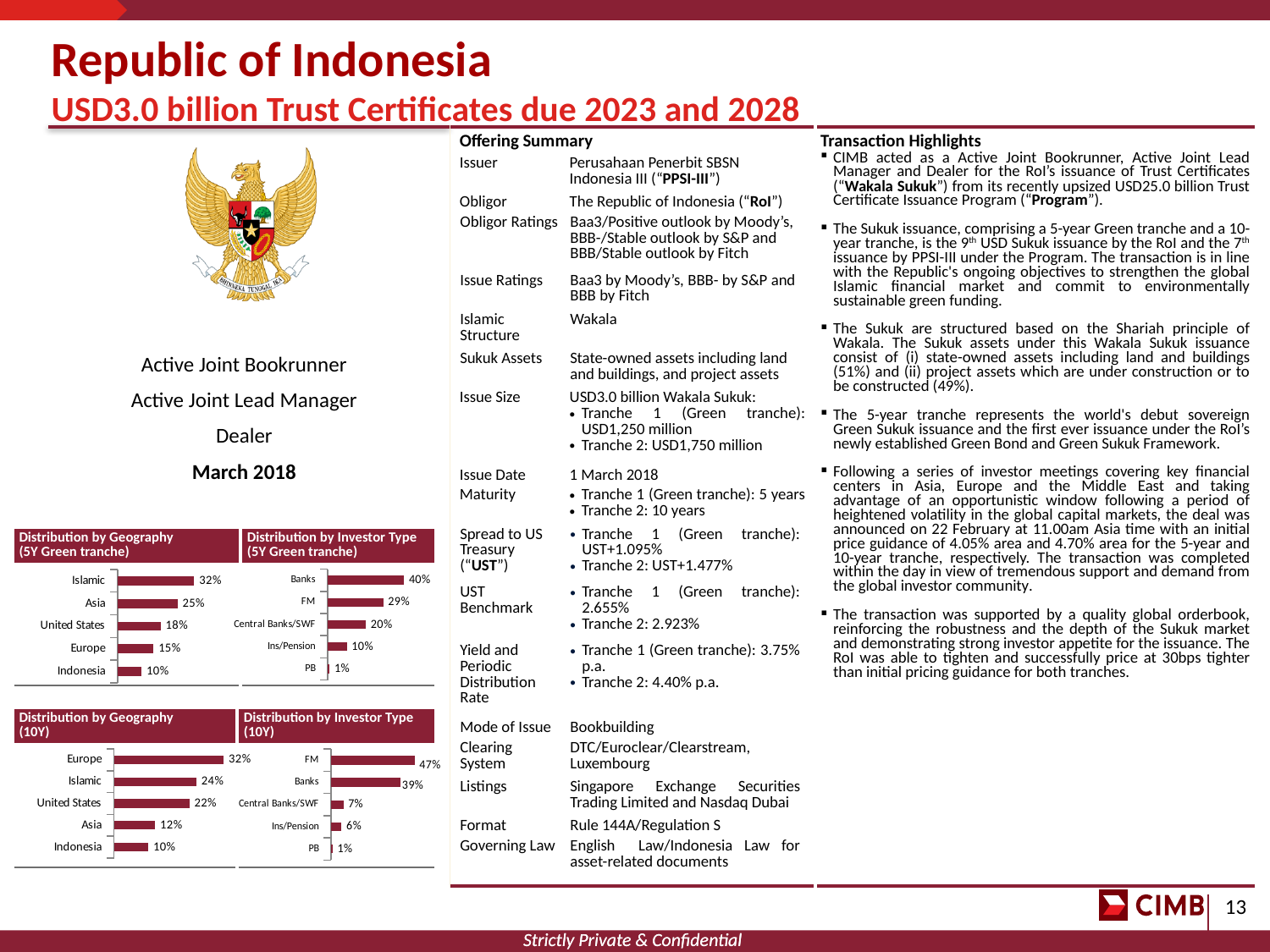
In the Distribution by Investor Type (10Y) chart, what is the difference between FM and Banks? 8% In the Distribution by Geography (5Y Green tranche) chart, what is the value for Asia? 25% What type of chart is the Distribution by Investor Type (10Y) chart? Bar chart In the Distribution by Investor Type (5Y Green tranche) chart, which category has the lowest value? PB In the Distribution by Geography (5Y Green tranche) chart, which category has the highest value? Islamic In the Distribution by Geography (10Y) chart, which is larger, Islamic or United States? Islamic In the Distribution by Investor Type (10Y) chart, what is the value for FM? 47% In the Distribution by Geography (10Y) chart, what is the difference between Asia and Indonesia? 2% In the Distribution by Geography (5Y Green tranche) chart, what is the difference between United States and Europe? 3% In the Distribution by Investor Type (5Y Green tranche) chart, what is the value for Central Banks/SWF? 20% In the Distribution by Geography (10Y) chart, what is the value for Europe? 32% In the Distribution by Investor Type (5Y Green tranche) chart, how many categories are shown? 5